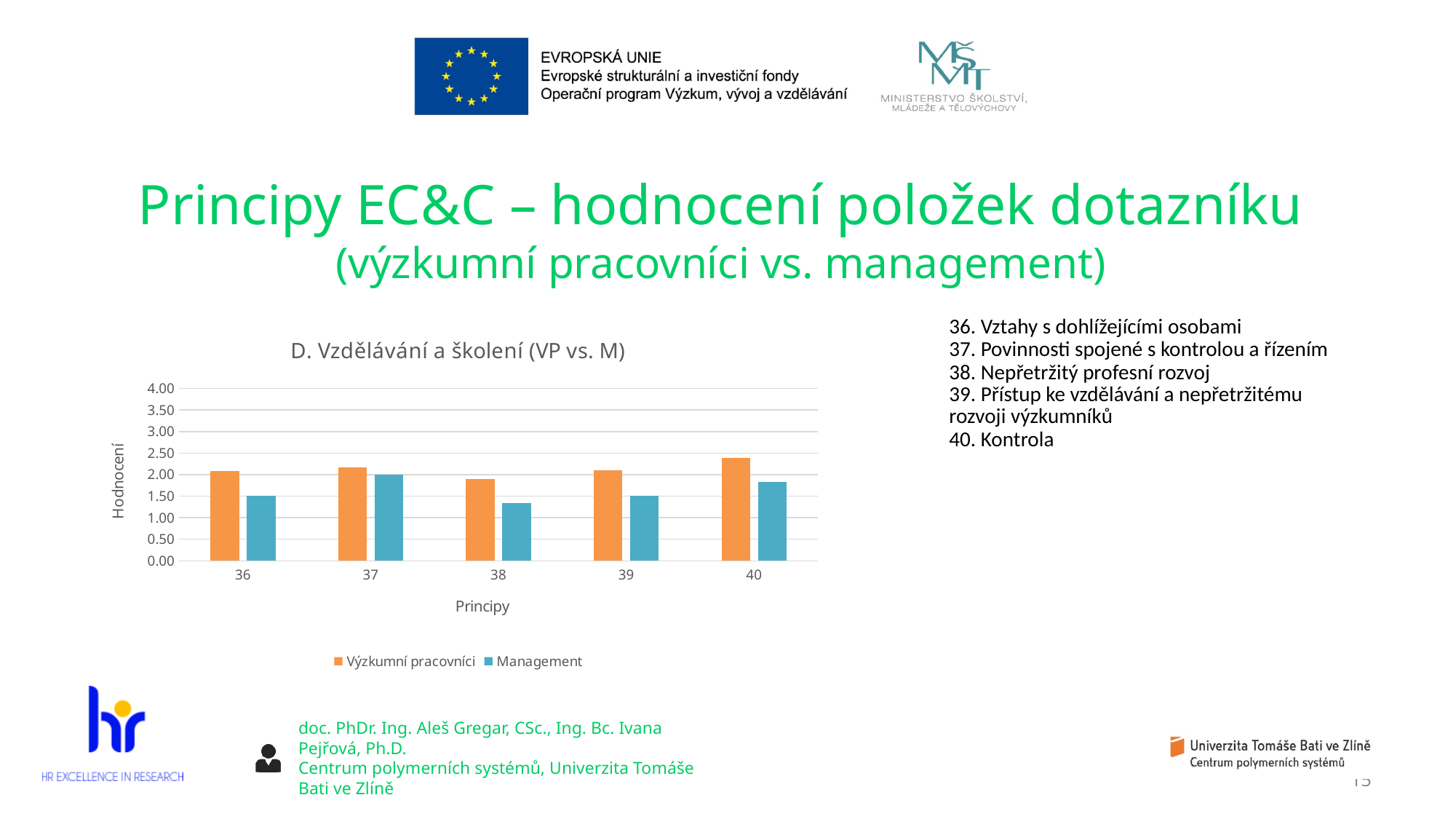
For which principle is the Výzkumní pracovníci value highest? 40 What are the two series named in the chart legend? Výzkumní pracovníci and Management How many principles (categories) are shown on the x axis of the chart? 5 For principle 36, which series has the larger value, Výzkumní pracovníci or Management? Výzkumní pracovníci For which principle is the Management value highest? 37 For which principle is the Výzkumní pracovníci value lowest? 38 What kind of chart is shown on the slide? bar chart For which principle is the Management value lowest? 38 What is the title of the chart? D. Vzdělávání a školení (VP vs. M) Is the Management value for principle 38 greater or less than 1.50? less How many series does the chart legend list? 2 Is the Výzkumní pracovníci value for principle 40 greater or less than 2.00? greater